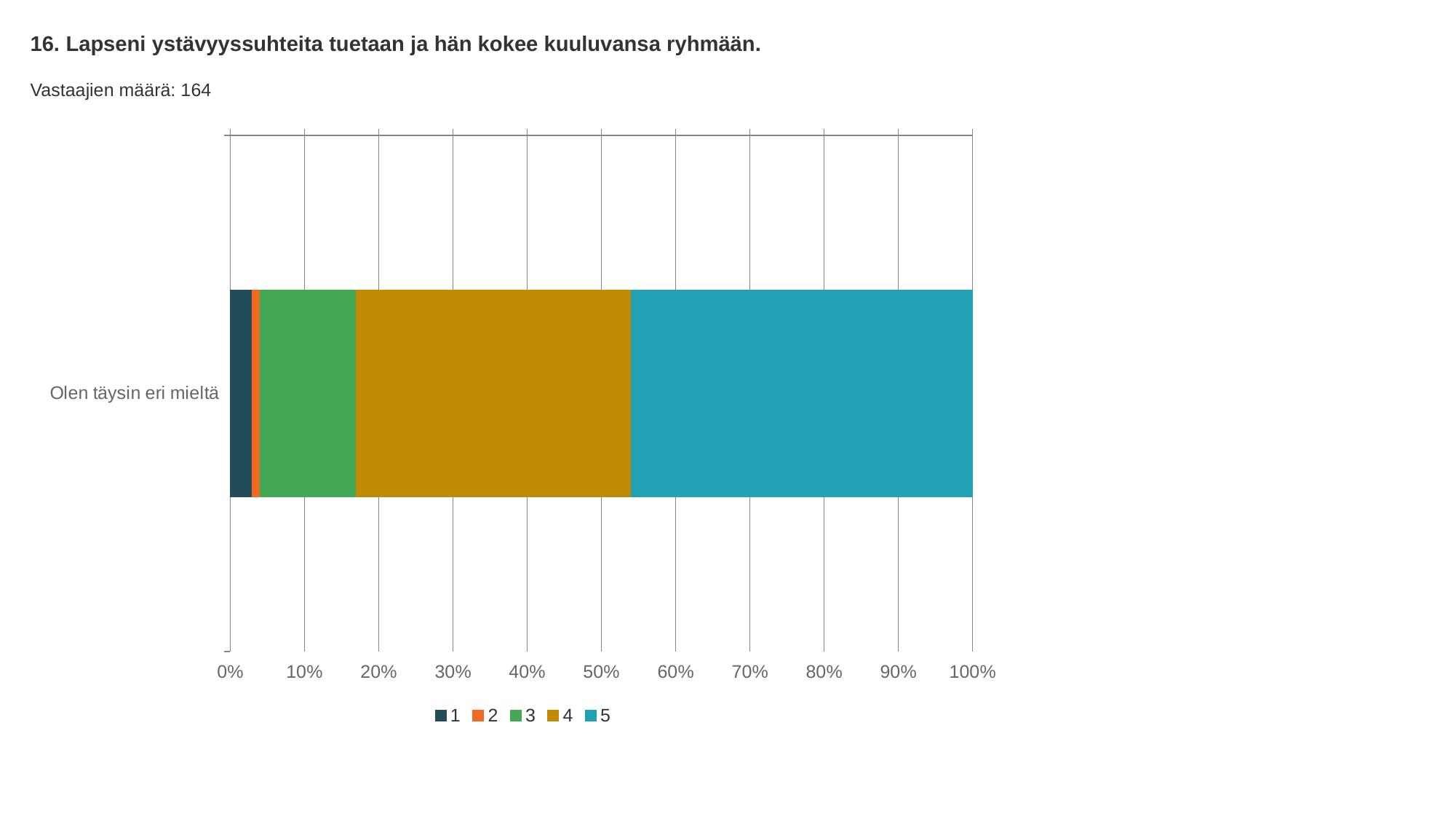
How many series does the legend list? 5 Which segment is larger in the bar: series 5 or series 4? 5 How many respondents (Vastaajien määrä) are reported on the slide? 164 How many categories are plotted on the y axis? 1 Which series has the largest segment in the bar for 'Olen täysin eri mieltä'? 5 Is the share for series 4 greater or less than 30%? greater Is the share for series 1 greater or less than 10%? less What is the total of the stacked bar for 'Olen täysin eri mieltä'? 100% Is the share for series 5 greater or less than 40%? greater Which segment is larger in the bar: series 4 or series 3? 4 What kind of chart is shown on the slide? stacked bar chart Which series has the smallest segment in the bar for 'Olen täysin eri mieltä'? 2